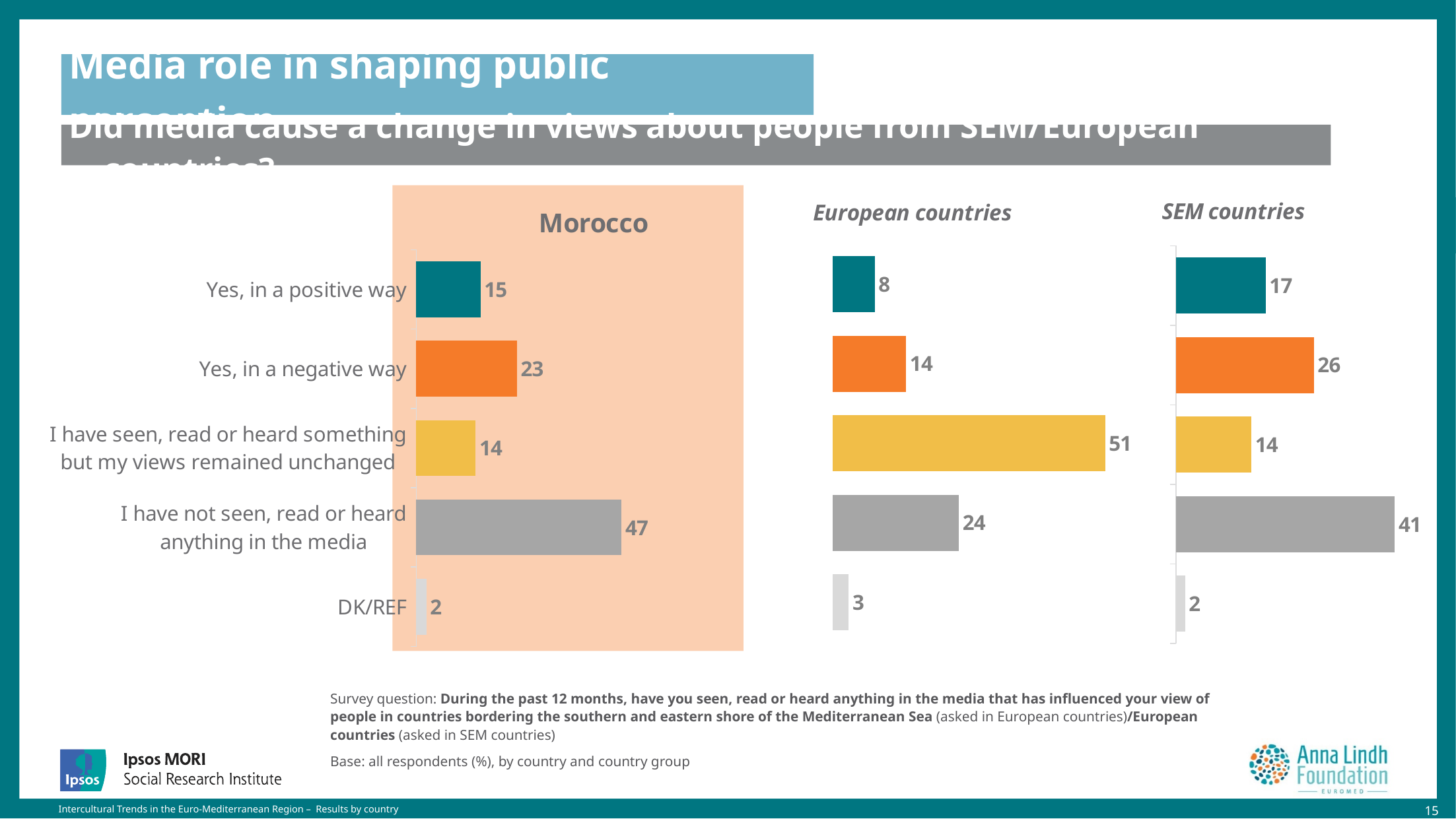
What is the value for DK/REF in the Morocco chart? 2 In the SEM countries chart, what is the value for 'Yes, in a positive way'? 17 In the European countries chart, what is the difference between 'Yes, in a negative way' and 'Yes, in a positive way'? 6 In the Morocco chart, what is the value for 'Yes, in a negative way'? 23 How many categories does the Morocco chart show? 5 In the SEM countries chart, what is the difference between 'I have not seen, read or heard anything in the media' and 'Yes, in a negative way'? 15 In the Morocco chart, which category has the highest value? I have not seen, read or heard anything in the media What kind of chart is the Morocco chart? Bar chart In the SEM countries chart, which category has the highest value? I have not seen, read or heard anything in the media In the European countries chart, what is the value for 'I have seen, read or heard something but my views remained unchanged'? 51 In the Morocco chart, which is larger: 'Yes, in a positive way' or 'Yes, in a negative way'? Yes, in a negative way In the European countries chart, which category has the lowest value? DK/REF